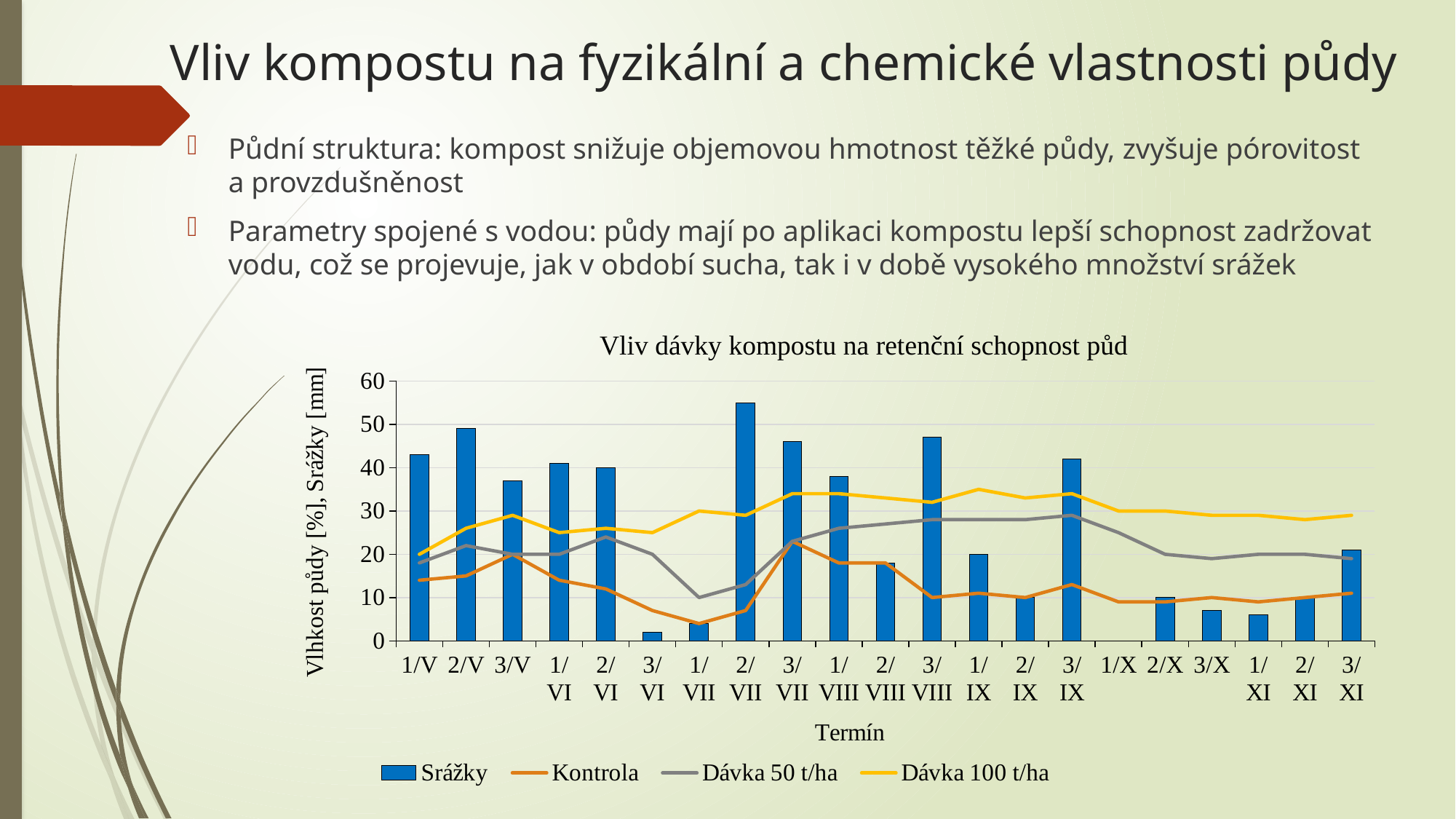
Which series in the chart is drawn as bars? Srážky How many categories (termíny) are shown on the x axis of the chart? 21 Is the Dávka 100 t/ha value for 1/IX greater or less than 30? greater Is the Srážky value for 3/VI greater or less than 10? less What is the title of the chart? Vliv dávky kompostu na retenční schopnost půd Is the Srážky value for 2/V greater or less than 40? greater At which termín is the Srážky bar the highest? 2/VII What kind of chart is shown on the slide? Combined bar and line chart At 3/VIII, which is larger: the Dávka 100 t/ha value or the Kontrola value? Dávka 100 t/ha How many series does the chart legend list? 4